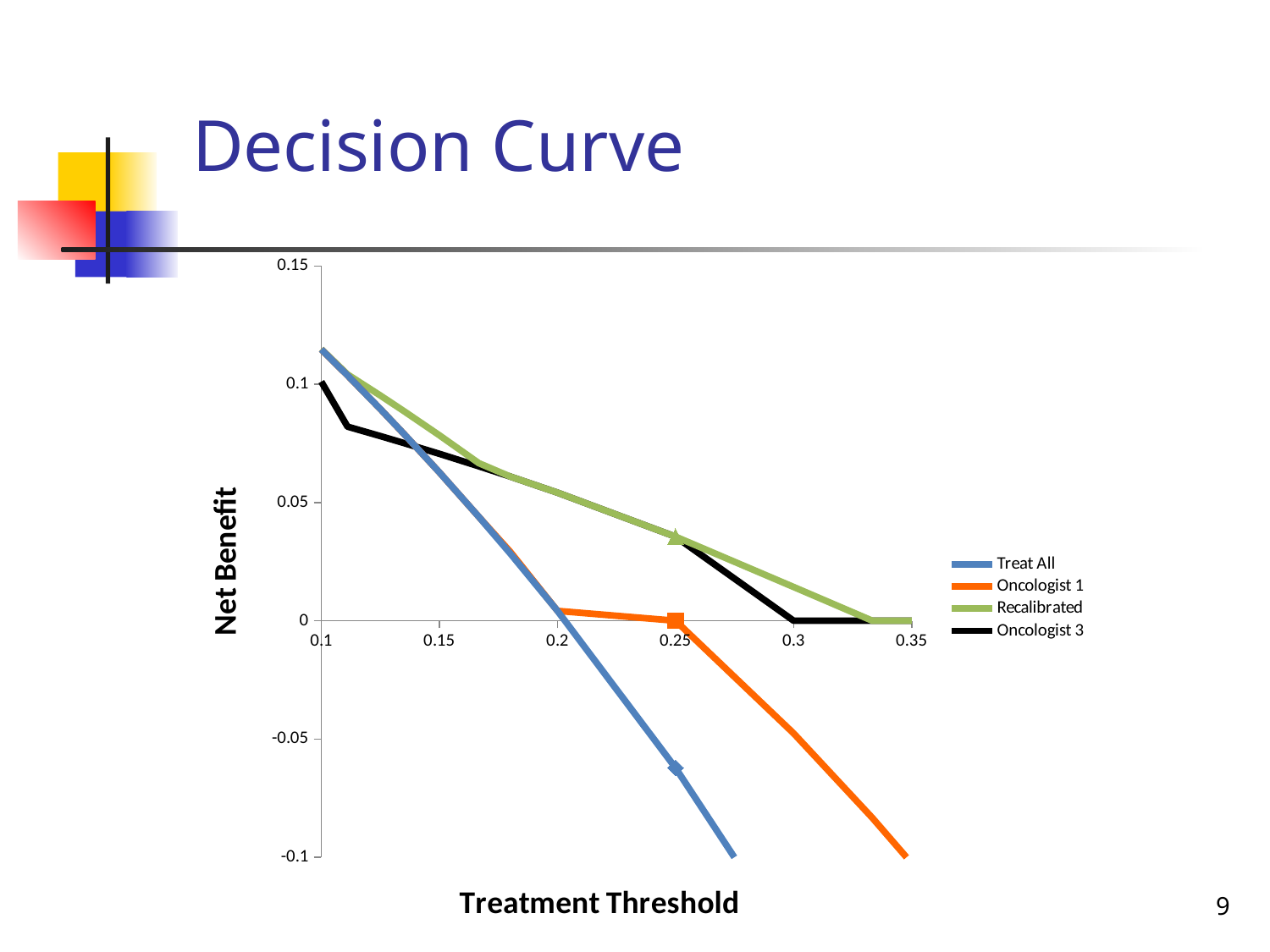
What is the Net Benefit for Oncologist 3 at a Treatment Threshold of 0.3? 0 What is the title of the chart? Decision Curve What is the label of the vertical axis? Net Benefit What is the Net Benefit for Oncologist 1 at a Treatment Threshold of 0.25? 0 What kind of chart is shown on the slide? line chart Does the Net Benefit for Treat All rise or fall as the Treatment Threshold increases? fall Is the Net Benefit for Treat All at a Treatment Threshold of 0.25 greater or less than -0.05? less At a Treatment Threshold of 0.25, which series has the higher Net Benefit, Treat All or Oncologist 1? Oncologist 1 Is the Net Benefit for Recalibrated at a Treatment Threshold of 0.15 greater or less than 0.05? greater How many series does the legend list? 4